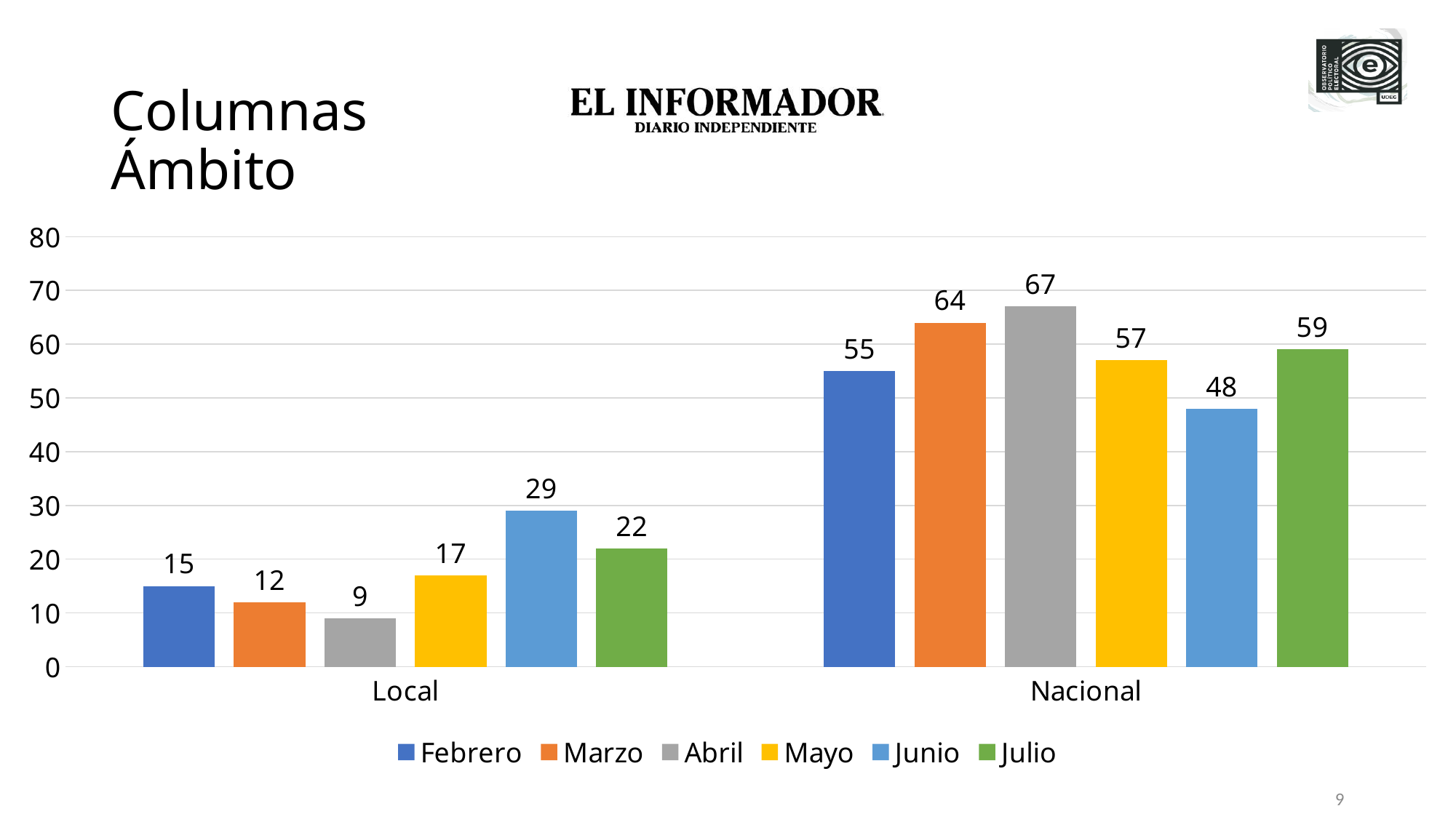
Which month has the highest value in the Nacional category? Abril How many categories are shown on the x axis? 2 Which month has the lowest value in the Local category? Abril What is the difference between the Marzo values for Nacional and Local? 52 Which is larger in the Local category, Mayo or Julio? Julio Is the value for Junio in the Nacional category greater or less than 50? less What colour represents Mayo in the chart? yellow What is the value for Junio in the Local category? 29 How many series does the legend list? 6 What kind of chart is shown on the slide? bar chart What is the value for Abril in the Nacional category? 67 What is the value for Febrero in the Nacional category? 55